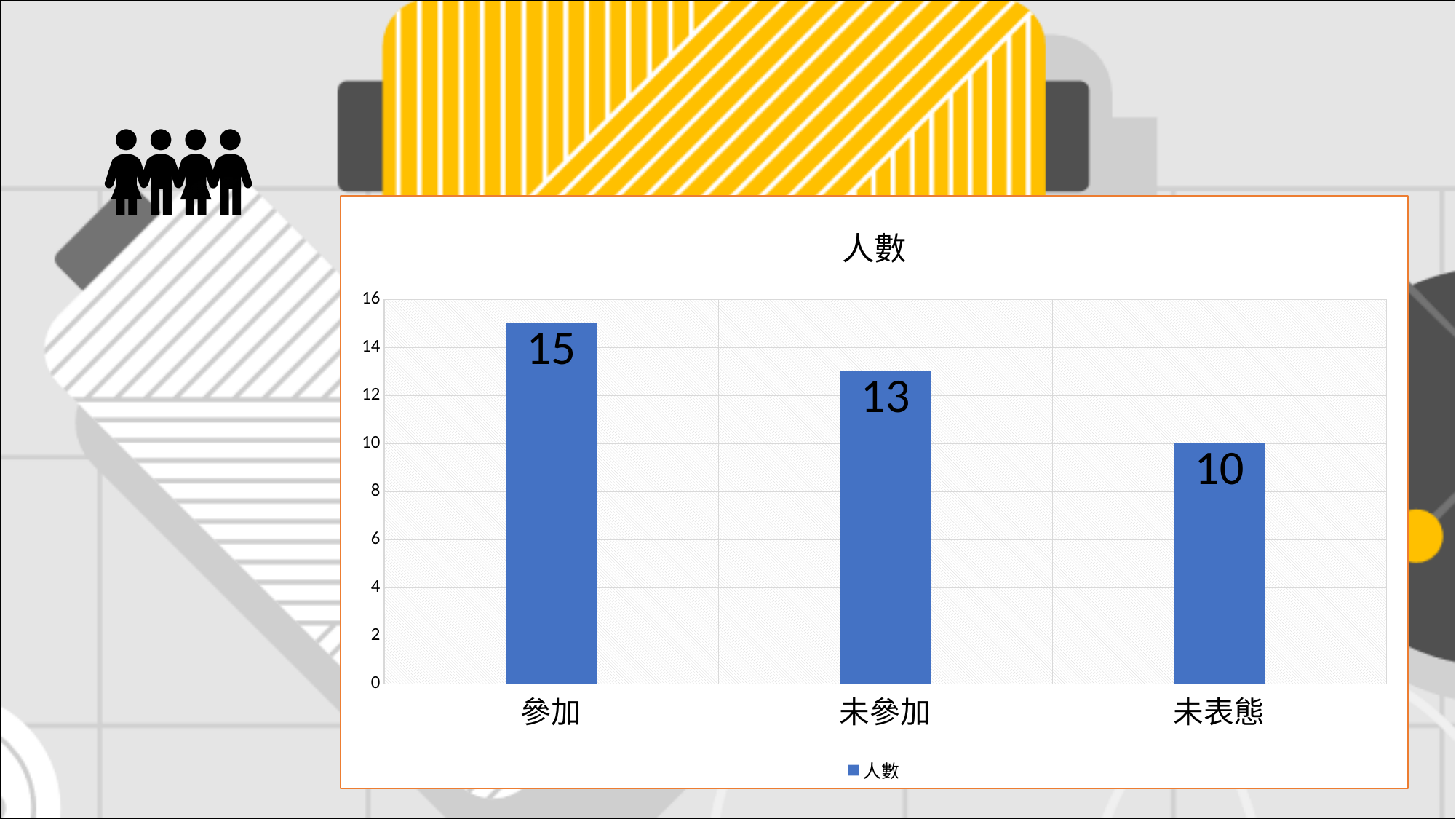
What kind of chart is shown? bar chart What is the difference between the values for 參加 and 未參加? 2 How many categories are shown on the x axis? 3 What is the title of the chart? 人數 Which is larger, the value for 未參加 or the value for 未表態? 未參加 How many series does the legend list? 1 What is the difference between the values for 參加 and 未表態? 5 What is the value for 未參加? 13 What is the value for 參加? 15 What is the value for 未表態? 10 Which category has the lowest value? 未表態 Which category has the highest value? 參加